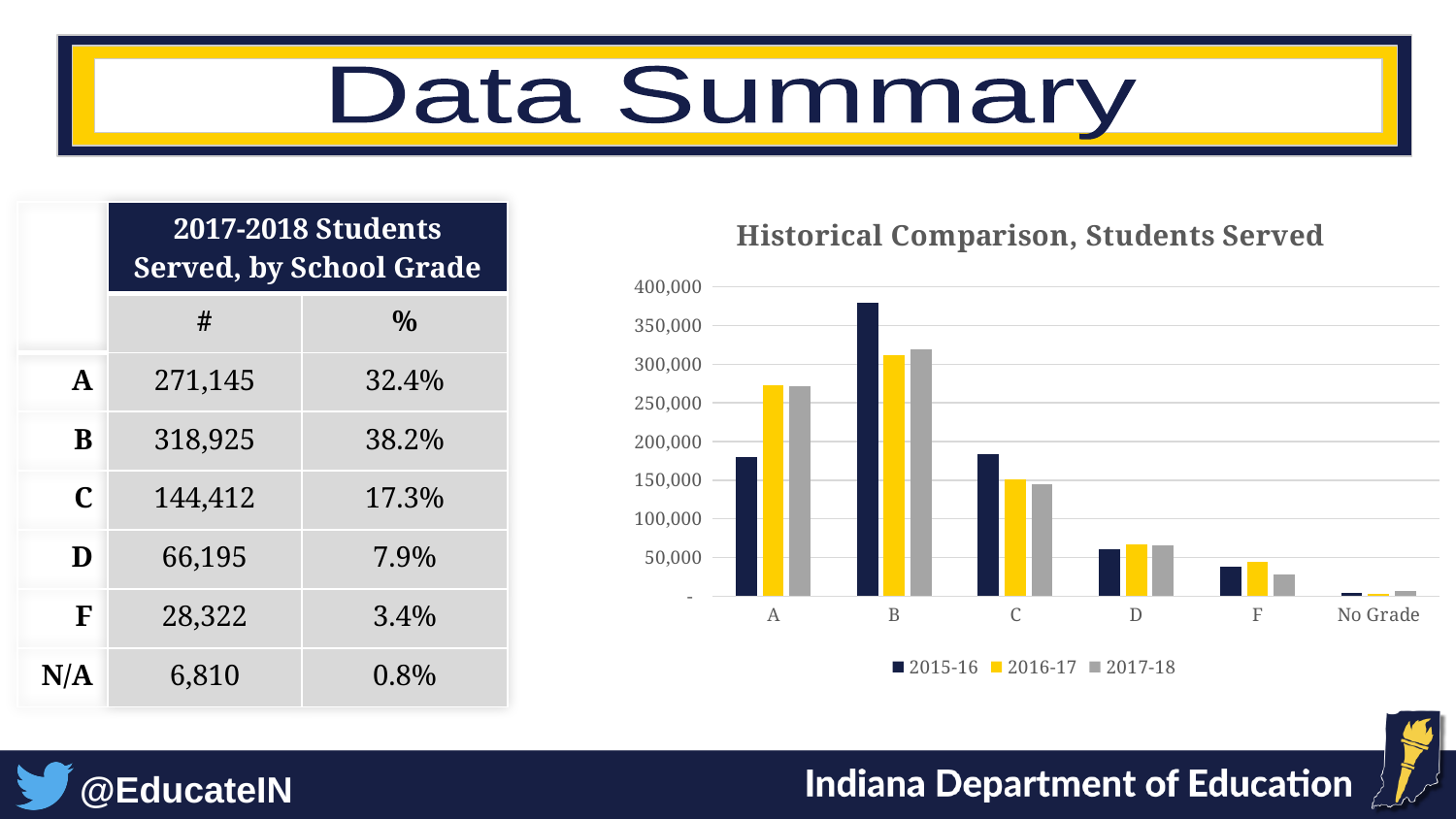
How many categories are shown on the x axis of the "Historical Comparison, Students Served" chart? 6 In the "Historical Comparison, Students Served" chart, is the 2016-17 value for A greater or less than 250,000? greater In the "Historical Comparison, Students Served" chart, do the 2016-17 values rise or fall from B to No Grade? fall How many series does the legend of the "Historical Comparison, Students Served" chart list? 3 In the "Historical Comparison, Students Served" chart, which category has the lowest 2017-18 value? No Grade What are the three legend entries of the "Historical Comparison, Students Served" chart? 2015-16, 2016-17, 2017-18 What kind of chart is "Historical Comparison, Students Served"? bar chart In the "Historical Comparison, Students Served" chart, for category C, which is larger: the 2015-16 value or the 2017-18 value? 2015-16 In the "Historical Comparison, Students Served" chart, which category has the highest 2015-16 value? B In the "Historical Comparison, Students Served" chart, is the 2015-16 value for B greater or less than 350,000? greater In the "Historical Comparison, Students Served" chart, for category A, which is larger: the 2015-16 value or the 2016-17 value? 2016-17 In the "Historical Comparison, Students Served" chart, is the 2015-16 value for D greater or less than 100,000? less